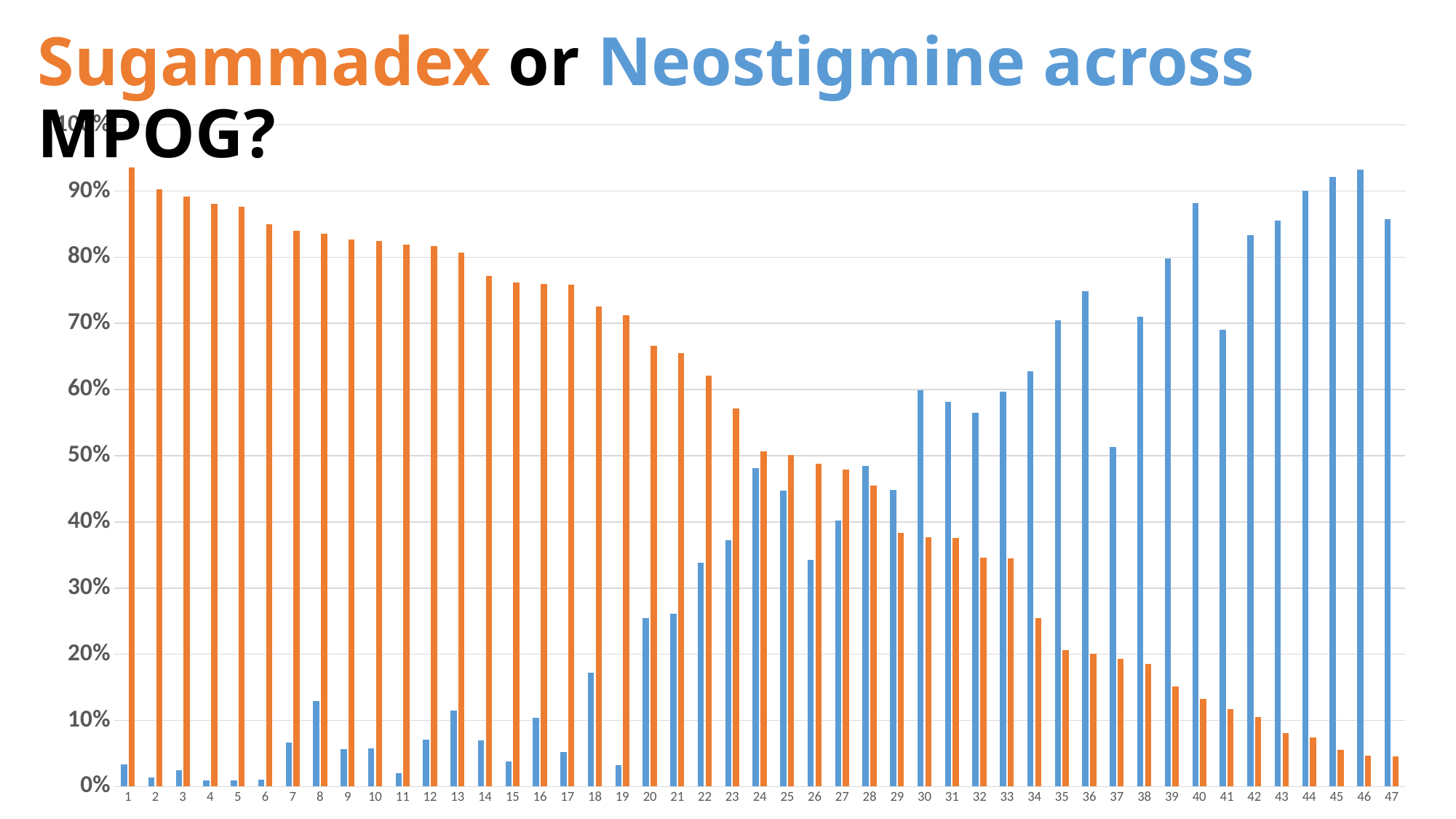
Which colour represents Sugammadex in the chart? orange Is the Sugammadex value for category 47 greater or less than 10%? less Is the Neostigmine value for category 40 greater or less than 80%? greater Is the Sugammadex value for category 20 greater or less than 60%? greater Which colour represents Neostigmine in the chart? blue For category 10, which is larger, the Sugammadex value or the Neostigmine value? Sugammadex Do the Sugammadex values generally rise or fall from category 1 to category 47? fall How many categories are shown along the x axis? 47 For category 30, which is larger, the Sugammadex value or the Neostigmine value? Neostigmine What kind of chart is shown on the slide? bar chart